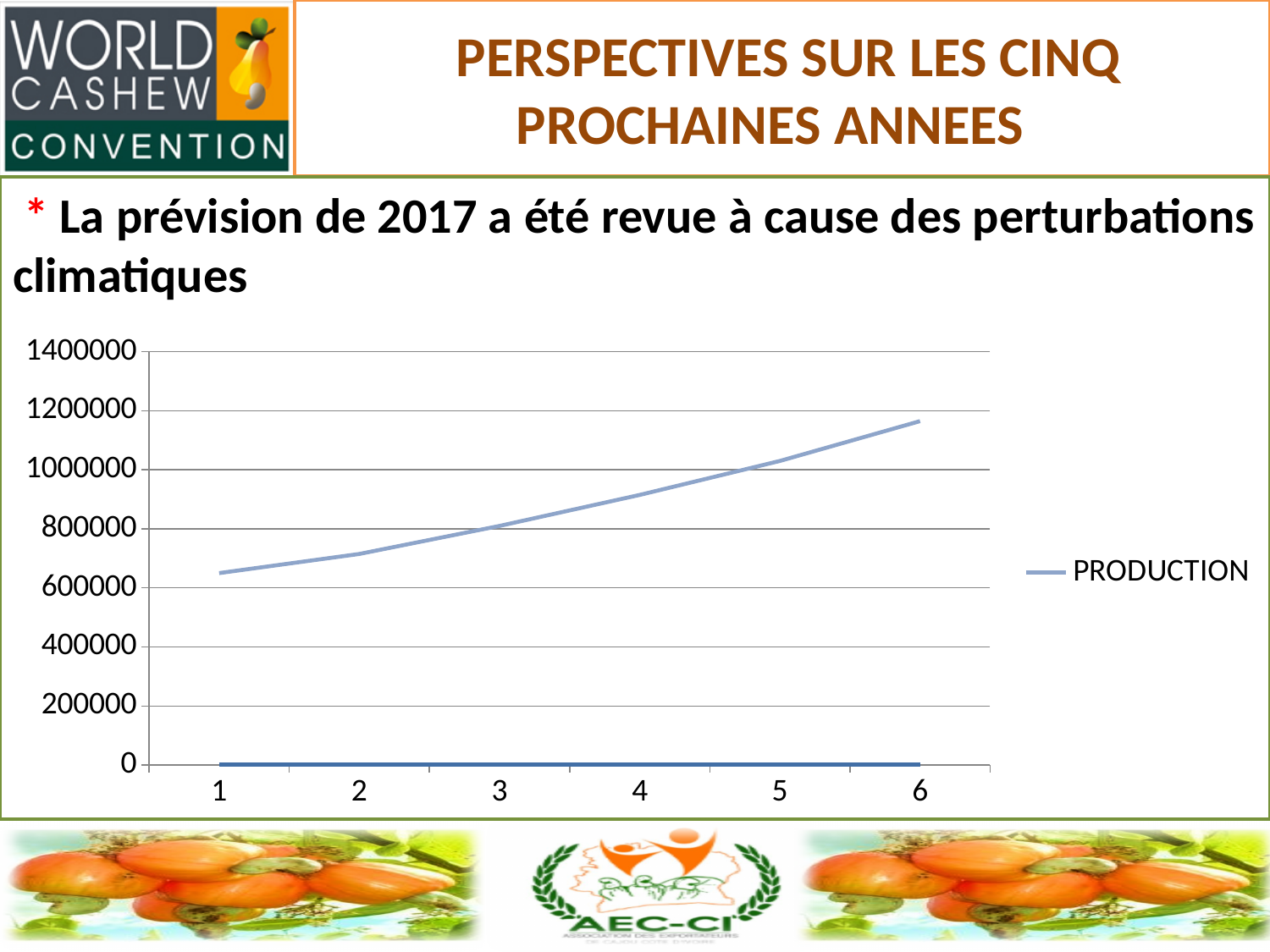
Does the PRODUCTION line rise or fall from point 1 to point 6? rises Is the PRODUCTION value at point 1 greater or less than 600000? greater At which x-axis point is PRODUCTION lowest? 1 Is the PRODUCTION value at point 6 greater or less than 1000000? greater At which x-axis point is PRODUCTION highest? 6 What kind of chart is shown on the slide? line chart How many series does the legend list? 1 What is the name of the series shown in the legend? PRODUCTION How many points are plotted along the x axis? 6 Is the PRODUCTION value at point 4 greater or less than 1000000? less Which has the larger PRODUCTION value, point 2 or point 5? 5